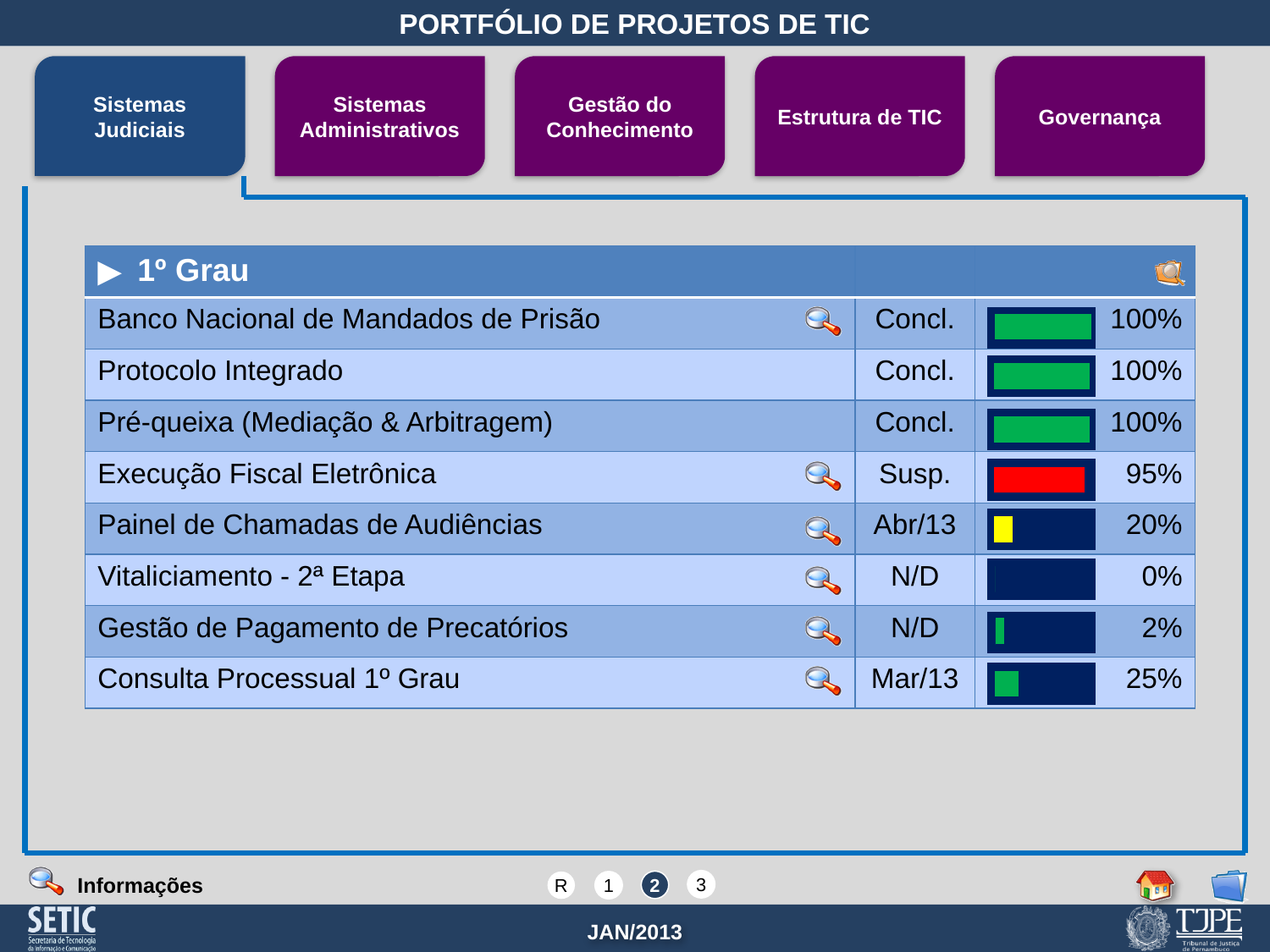
Which project has the lowest completion percentage? Vitaliciamento - 2ª Etapa What colour is the progress bar for Execução Fiscal Eletrônica? Red What kind of chart is used to show the completion of each project? Bar chart How many projects are listed in the 1º Grau table? 8 What is the completion percentage shown for Gestão de Pagamento de Precatórios? 2% What is the difference in completion percentage between Execução Fiscal Eletrônica and Painel de Chamadas de Audiências? 75% What is the completion percentage shown for Consulta Processual 1º Grau? 25% What is the completion percentage shown for Painel de Chamadas de Audiências? 20% What is the difference in completion percentage between Consulta Processual 1º Grau and Painel de Chamadas de Audiências? 5% How many projects show a completion of 100%? 3 Which has a higher completion percentage, Consulta Processual 1º Grau or Gestão de Pagamento de Precatórios? Consulta Processual 1º Grau What is the completion percentage shown for Execução Fiscal Eletrônica? 95%